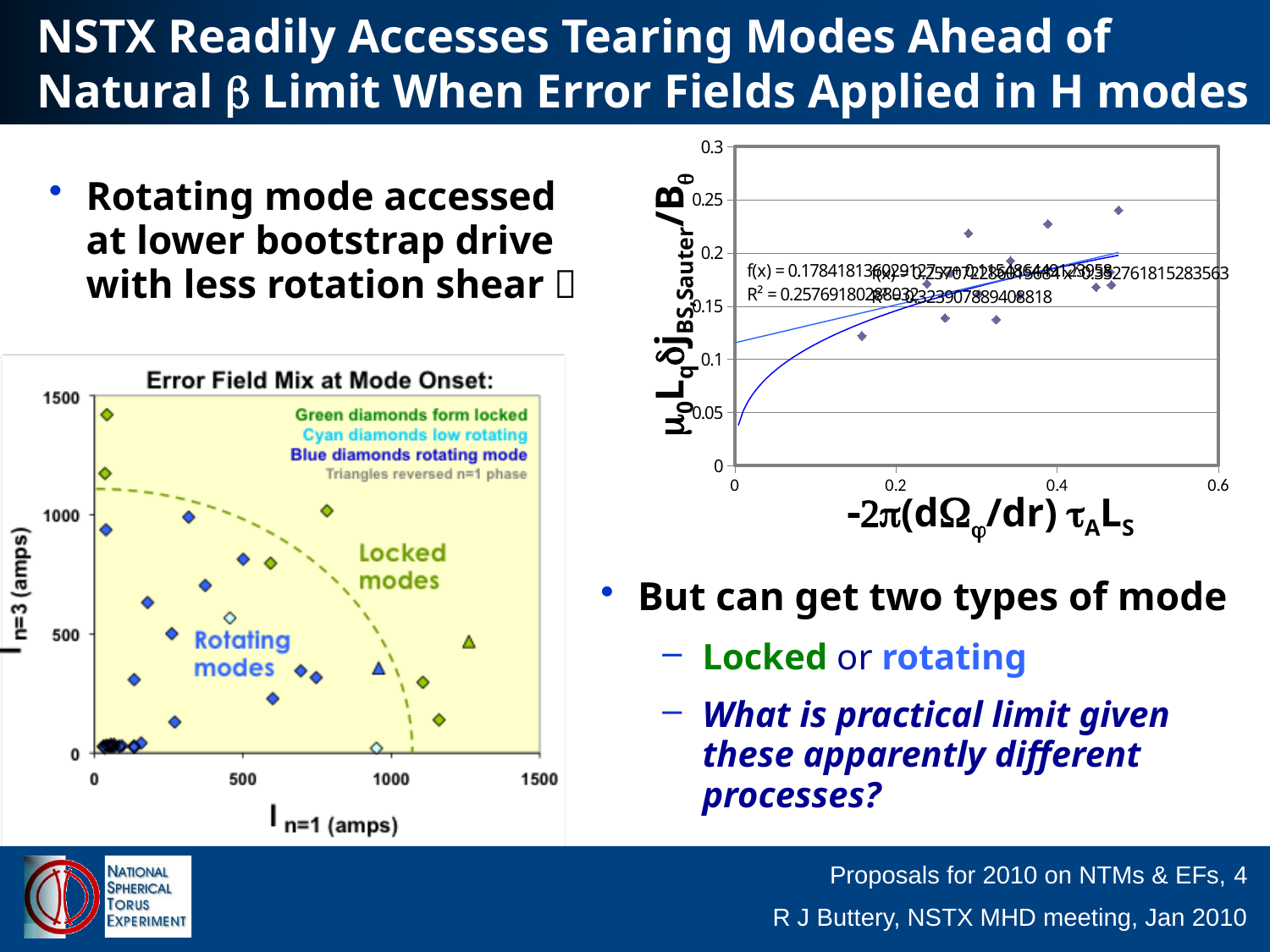
What kind of chart is the top-right chart plotting μ0Lqδj_BS,Sauter/Bθ against -2π(dΩφ/dr)τA L_S? scatter chart On the bottom-left 'Error Field Mix at Mode Onset' chart, what do the green diamonds represent? locked modes On the top-right scatter chart, is the smallest plotted x value greater or less than 0.2? less On the bottom-left 'Error Field Mix at Mode Onset' chart, is the highest I n=3 value plotted greater or less than 1000 amps? greater On the top-right scatter chart, is the largest plotted x value greater or less than 0.4? greater What is the title of the bottom-left chart? Error Field Mix at Mode Onset: On the top-right scatter chart, what is the maximum value shown on the x axis? 0.6 On the bottom-left 'Error Field Mix at Mode Onset' chart, how many triangle markers are plotted? 2